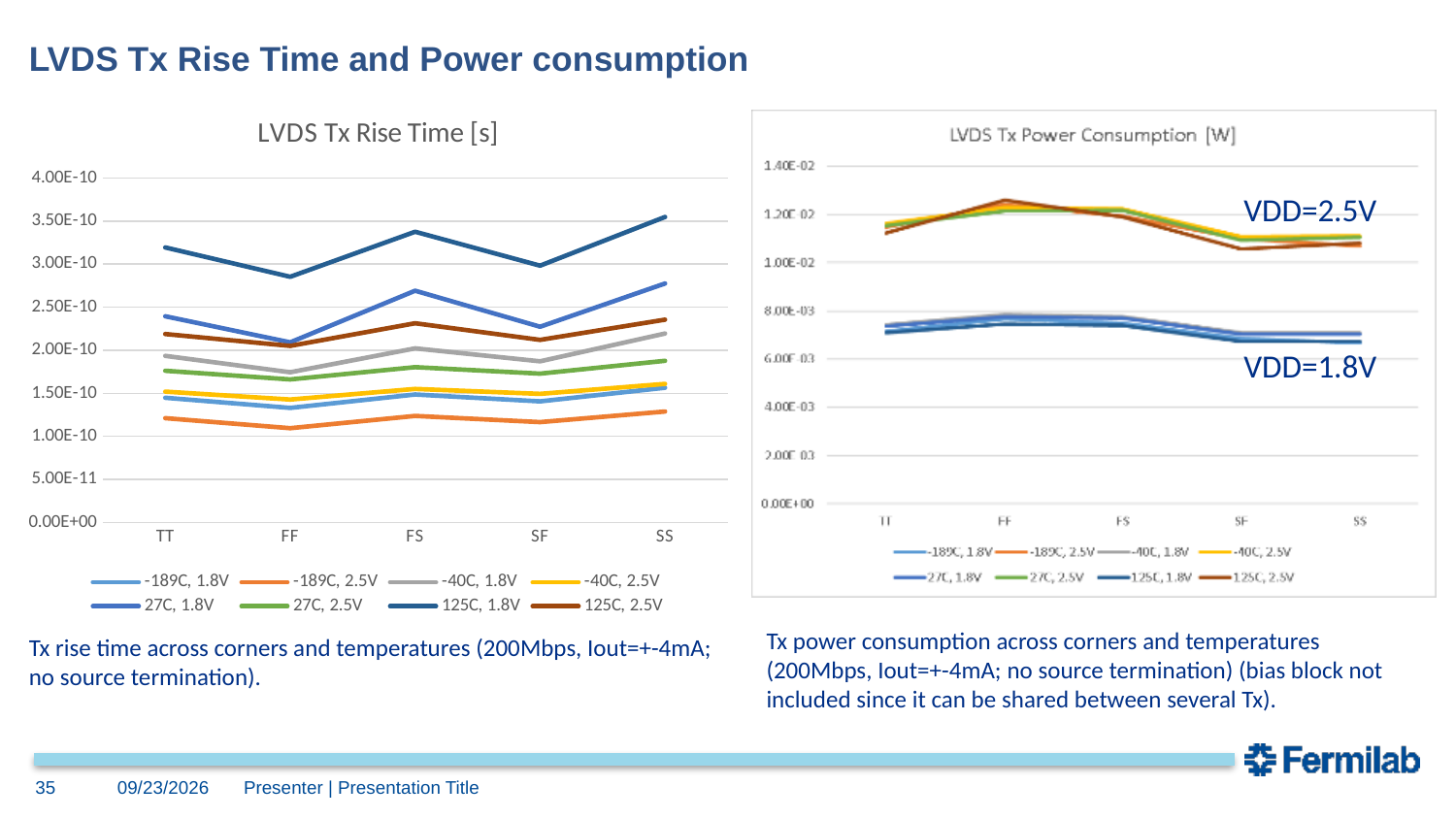
In the LVDS Tx Power Consumption [W] chart, which group of lines has higher power consumption: VDD=2.5V or VDD=1.8V? VDD=2.5V In the LVDS Tx Power Consumption [W] chart, are the VDD=1.8V values at FF greater or less than 8.00E-03? less In the LVDS Tx Rise Time [s] chart, which is larger at TT: 27C, 1.8V or 27C, 2.5V? 27C, 1.8V How many series does the legend of the LVDS Tx Rise Time [s] chart list? 8 How many corner categories are shown on the x axis of the LVDS Tx Rise Time [s] chart? 5 In the LVDS Tx Rise Time [s] chart, which series has the lowest rise time across all corners? -189C, 2.5V In the LVDS Tx Rise Time [s] chart, does the 125C, 1.8V series rise or fall from SF to SS? rise In the LVDS Tx Rise Time [s] chart, is the value for 125C, 1.8V at FS greater or less than 3.00E-10? greater In the LVDS Tx Rise Time [s] chart, which series has the highest rise time across all corners? 125C, 1.8V What type of chart is the LVDS Tx Rise Time [s] chart? line chart In the LVDS Tx Rise Time [s] chart, is the value for 125C, 1.8V at FF greater or less than 3.00E-10? less